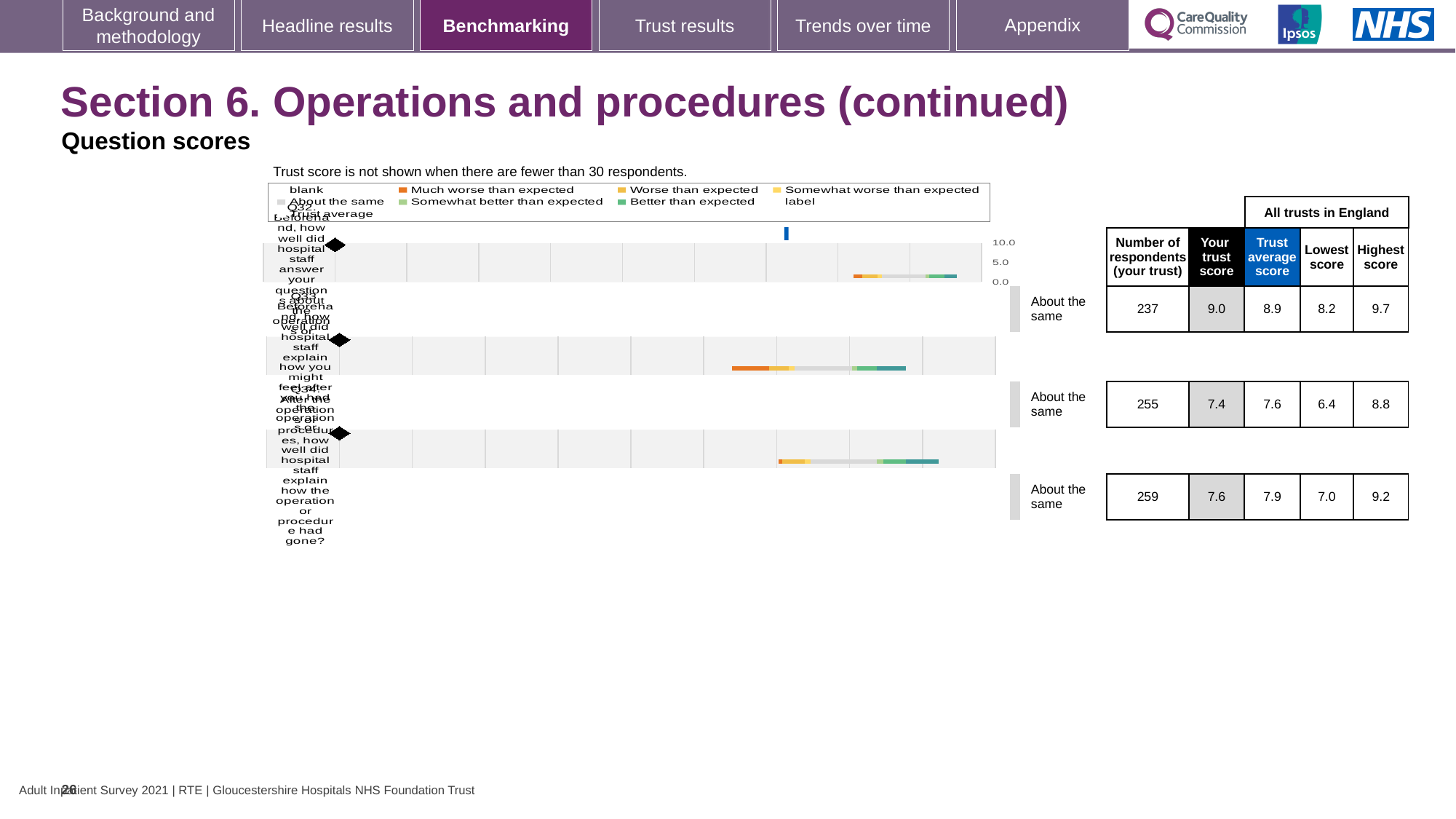
What benchmark category is shown next to each of the three question rows? About the same What is the highest score for the third (bottom) question row? 9.2 What is the trust average score for the second question row? 7.6 What is the number of respondents for the first (top) question row? 237 What is the lowest score for the third (bottom) question row? 7.0 What is the difference between the highest score and the lowest score for the first (top) question row? 1.5 What kind of chart is used to show the question scores on this slide? bar chart How many question rows are plotted in the benchmarking chart? 3 Which question row has the highest 'Your trust score'? the first (top) row, 9.0 What is the 'Your trust score' for the first (top) question row? 9.0 What is the difference between the trust average score and the 'Your trust score' for the third (bottom) question row? 0.3 For the second question row, is the 'Your trust score' higher or lower than the trust average score? lower